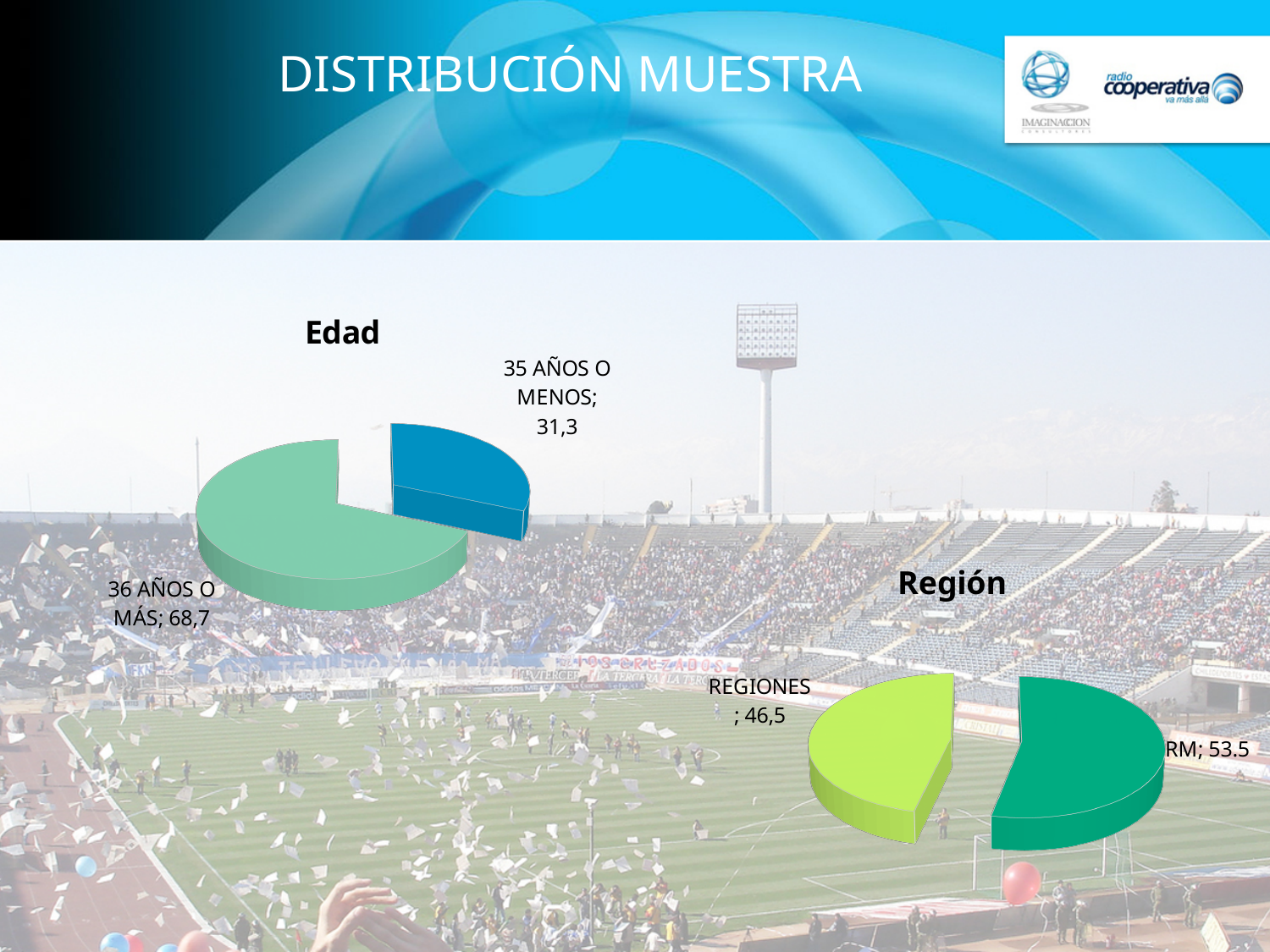
In the "Región" chart, which category has the smallest slice? REGIONES What kind of chart is the "Región" chart? Pie chart In the "Edad" chart, what is the value for "36 AÑOS O MÁS"? 68,7 In the "Región" chart, what is the value for "RM"? 53.5 How many slices does the "Edad" chart have? 2 What is the title of the chart on the left of the slide? Edad In the "Edad" chart, what is the difference between the values for "36 AÑOS O MÁS" and "35 AÑOS O MENOS"? 37,4 In the "Edad" chart, what is the value for "35 AÑOS O MENOS"? 31,3 In the "Edad" chart, which category has the largest slice? 36 AÑOS O MÁS In the "Región" chart, what is the value for "REGIONES"? 46,5 In the "Región" chart, which is larger, "RM" or "REGIONES"? RM How many charts are shown on the slide? 2